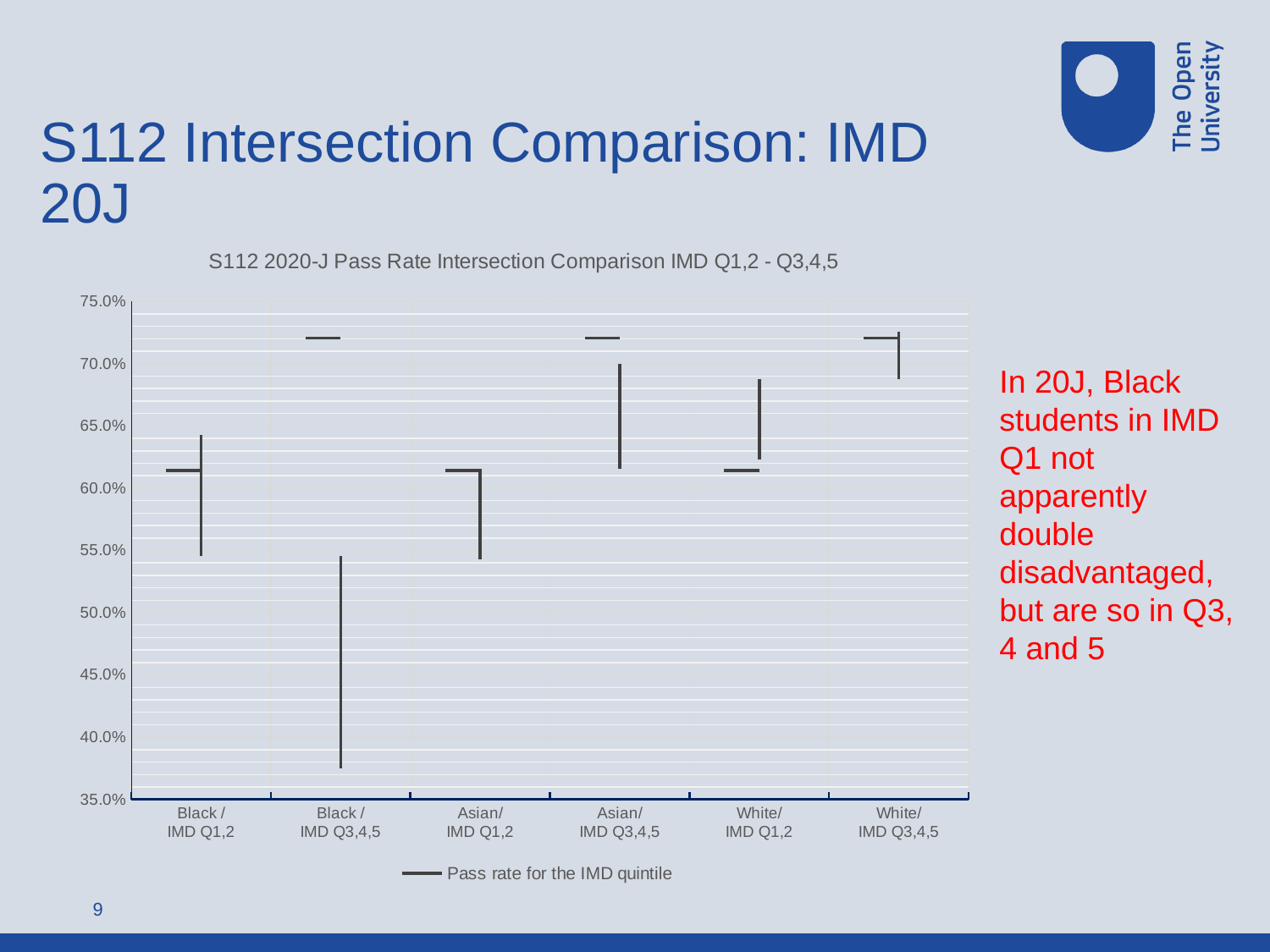
Is the lowest point of the vertical line for Black / IMD Q3,4,5 greater or less than 40.0%? less What is the lowest value shown on the y axis of the chart? 35.0% How many series does the chart legend list? 1 Which category has the vertical line reaching the lowest value on the chart? Black / IMD Q3,4,5 Is the pass rate for the IMD quintile marker for White/ IMD Q3,4,5 greater or less than 70.0%? greater Is the pass rate for the IMD quintile marker for Black / IMD Q1,2 greater or less than 60.0%? greater What is the title of the chart? S112 2020-J Pass Rate Intersection Comparison IMD Q1,2 - Q3,4,5 How many categories are shown on the x axis of the chart? 6 Which is higher: the pass rate for the IMD quintile marker for Black / IMD Q3,4,5 or for Black / IMD Q1,2? Black / IMD Q3,4,5 What is the legend entry shown below the chart? Pass rate for the IMD quintile